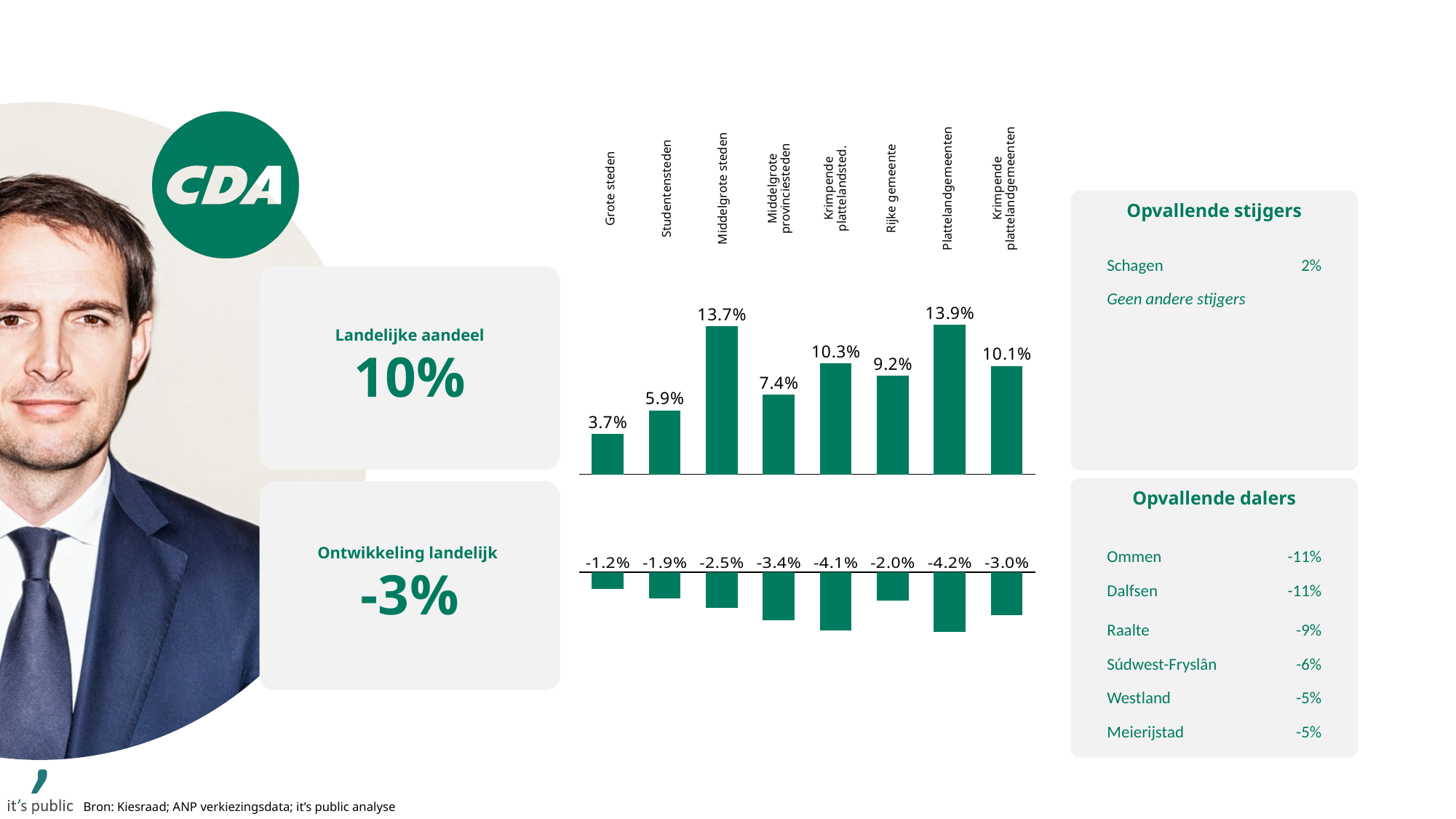
How many categories are shown in the upper chart? 8 In the upper chart, which category has the lowest value? Grote steden In the lower chart, what is the value for Krimpende plattelandsted.? -4.1% In the upper chart, what is the value for Rijke gemeente? 9.2% What kind of chart is the upper chart? Bar chart In the upper chart, what is the value for Middelgrote steden? 13.7% In the lower chart, what is the value for Studentensteden? -1.9% In the upper chart, which is larger: the value for Studentensteden or the value for Middelgrote provinciesteden? Middelgrote provinciesteden In the lower chart, what is the difference between the values for Grote steden and Krimpende plattelandgemeenten? 1.8% In the lower chart, which category has the lowest (most negative) value? Plattelandgemeenten In the upper chart, what is the difference between the values for Krimpende plattelandsted. and Middelgrote provinciesteden? 2.9% In the upper chart, which category has the highest value? Plattelandgemeenten